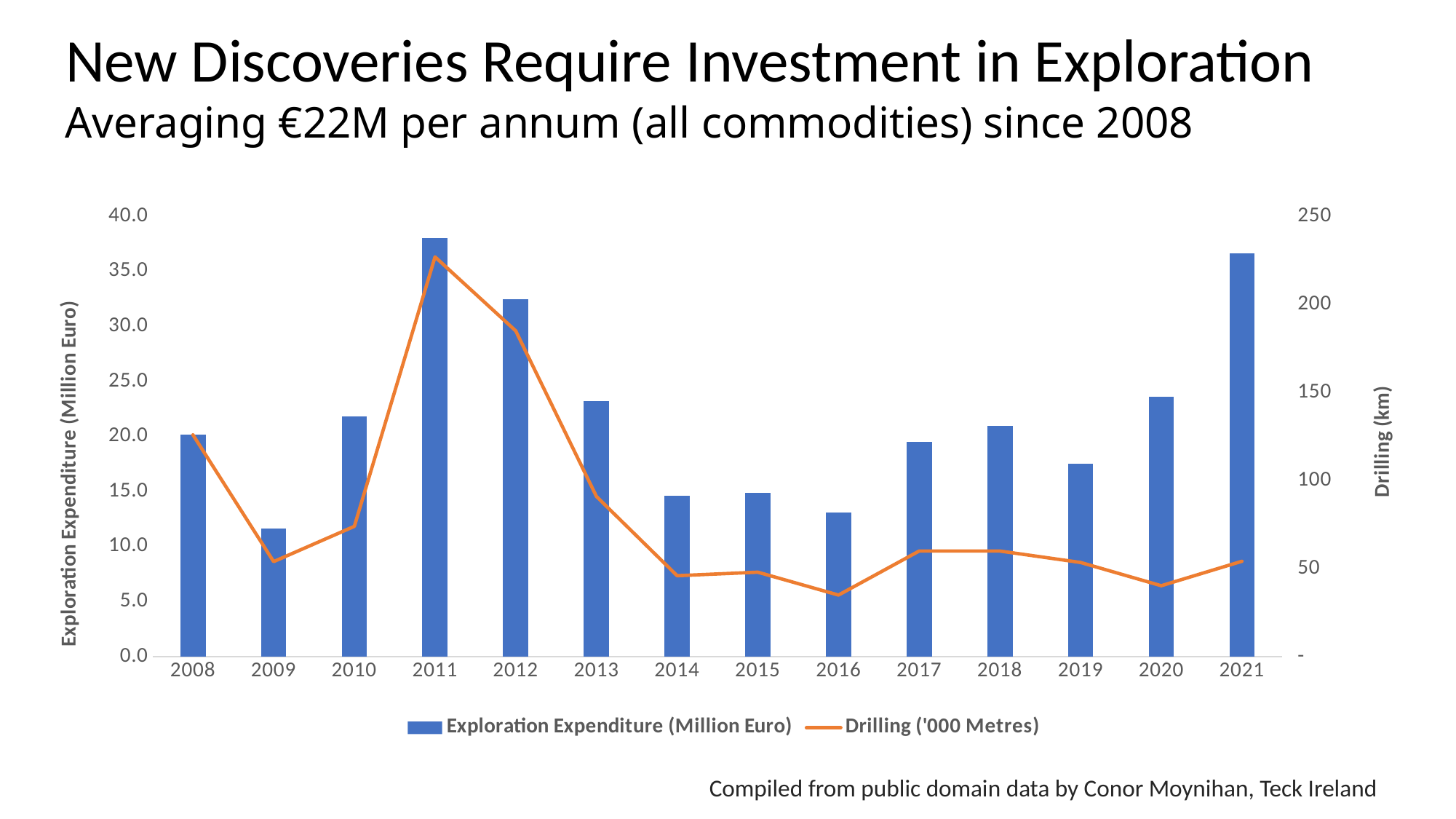
How many years are shown on the x axis of the chart? 14 Which year has the lowest Exploration Expenditure bar? 2009 In which year is the Drilling line at its lowest point? 2016 How many series does the chart legend list? 2 Does the Exploration Expenditure rise or fall from 2011 to 2016? fall Which year has the larger Exploration Expenditure, 2019 or 2020? 2020 Which year has the highest Exploration Expenditure bar? 2011 Which year has the larger Exploration Expenditure, 2012 or 2013? 2012 Is the Exploration Expenditure for 2011 greater or less than 35.0 million euro? greater Is the Exploration Expenditure for 2012 greater or less than 30.0 million euro? greater Is the Exploration Expenditure for 2009 greater or less than 15.0 million euro? less In which year does the Drilling line reach its peak? 2011